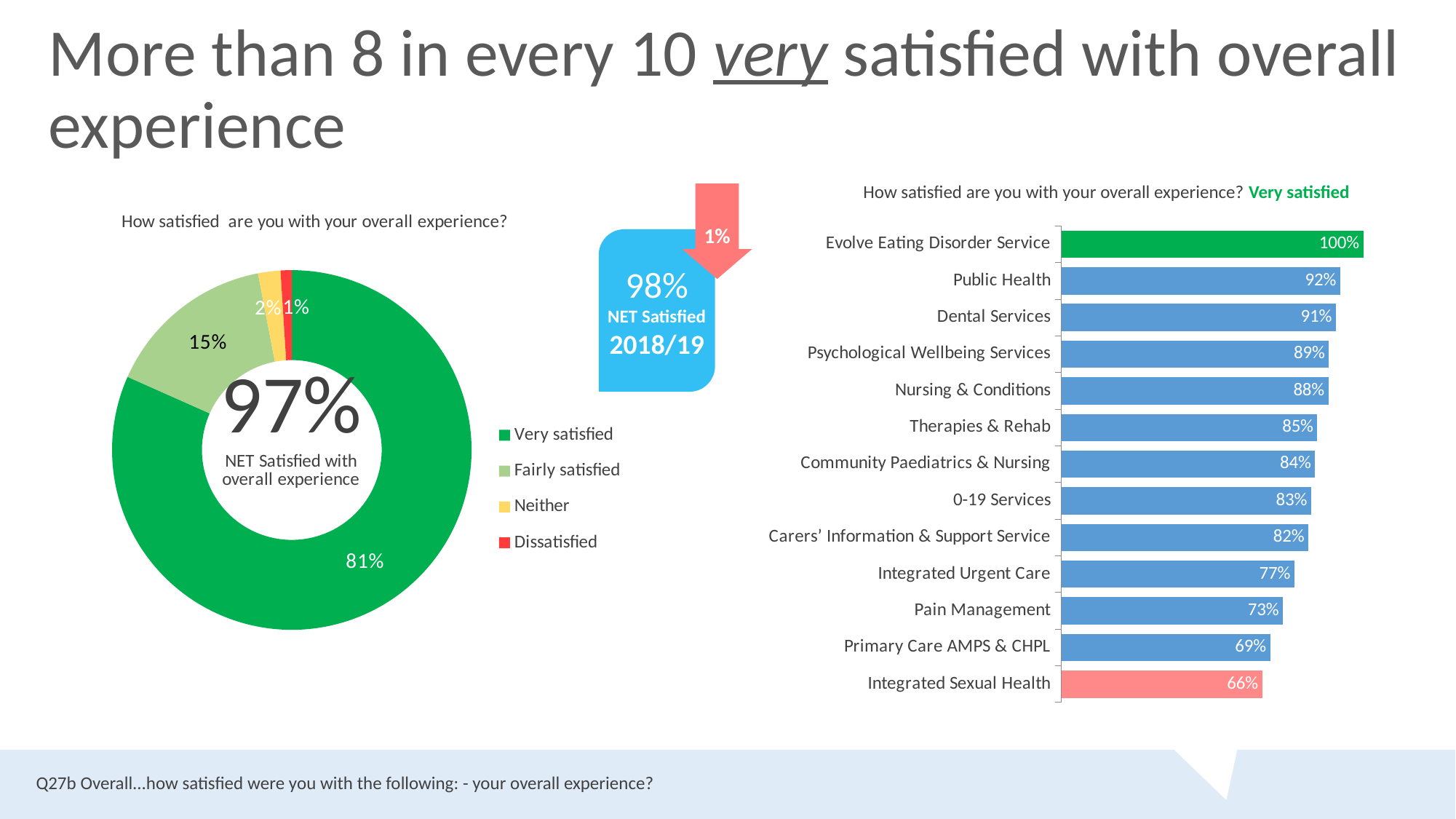
In the bar chart on the right, what is the difference between the values for Dental Services and Integrated Urgent Care? 14% In the doughnut chart on the left, what percentage of respondents were very satisfied with their overall experience? 81% In the bar chart on the right, what is the value for Public Health? 92% How many services are shown in the bar chart on the right? 13 In the bar chart on the right, what is the value for Pain Management? 73% In the doughnut chart on the left, what percentage of respondents were fairly satisfied? 15% In the bar chart on the right, which service has the lowest percentage of very satisfied respondents? Integrated Sexual Health In the doughnut chart on the left, which category has the smallest share? Dissatisfied In the bar chart on the right, which has a higher value: Therapies & Rehab or 0-19 Services? Therapies & Rehab In the doughnut chart on the left, how many categories does the legend list? 4 In the bar chart on the right, which service has the highest percentage of very satisfied respondents? Evolve Eating Disorder Service What type of chart is shown on the right side of the slide? Bar chart